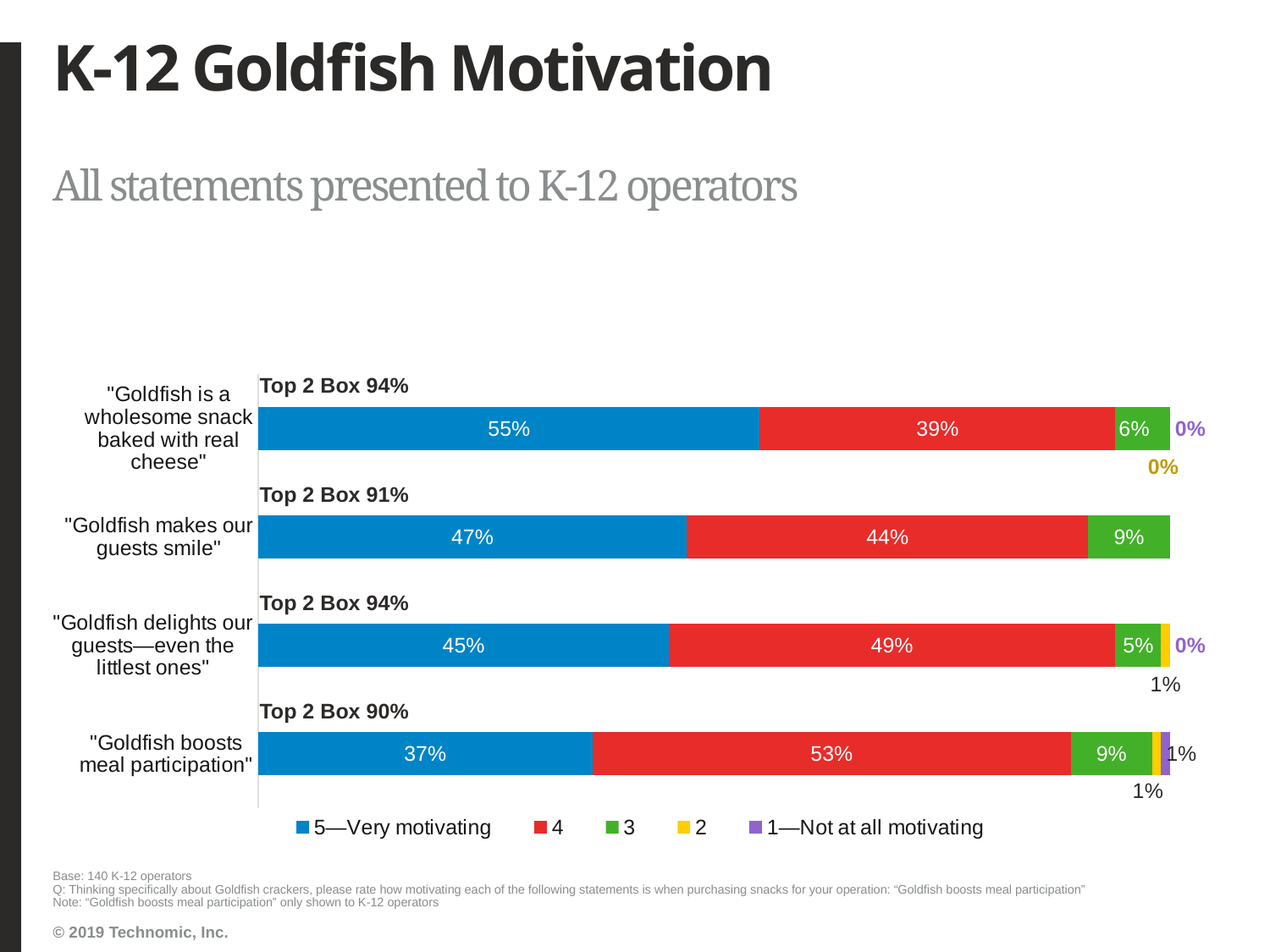
What share of operators gave a rating of 4 to "Goldfish delights our guests—even the littlest ones"? 49% What type of chart is shown on the slide? Stacked bar chart Which statement has the highest share of 5—Very motivating ratings? "Goldfish is a wholesome snack baked with real cheese" What is the difference between the 5—Very motivating share for "Goldfish is a wholesome snack baked with real cheese" and for "Goldfish boosts meal participation"? 18% What is the combined share of 5—Very motivating and 4 ratings for "Goldfish makes our guests smile"? 91% How many series does the legend list? 5 What percentage rated "Goldfish makes our guests smile" as a 3? 9% Which statement has the lowest share of 5—Very motivating ratings? "Goldfish boosts meal participation" How many statements are shown in the chart? 4 What is the Top 2 Box score for "Goldfish boosts meal participation"? 90% What percentage of K-12 operators rated "Goldfish is a wholesome snack baked with real cheese" as 5—Very motivating? 55% Which statement has a larger share of 4 ratings: "Goldfish makes our guests smile" or "Goldfish boosts meal participation"? "Goldfish boosts meal participation"